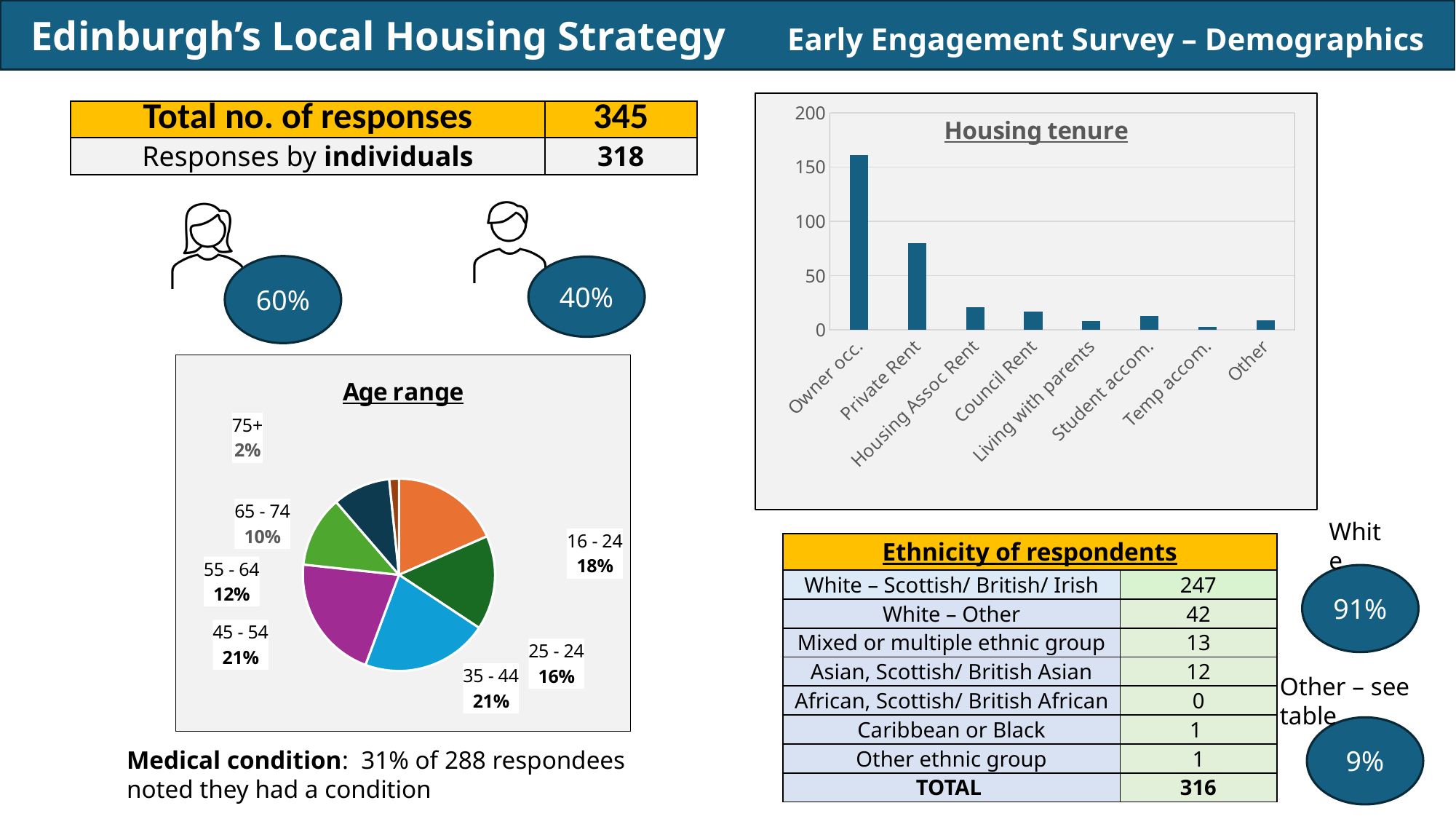
In the Housing tenure chart, which category has the highest value? Owner occ. In the Housing tenure chart, is the value for Owner occ. greater or less than 150? greater What kind of chart is the Age range chart? pie chart In the Housing tenure chart, which category has the lowest value? Temp accom. How many categories are shown in the Housing tenure chart? 8 In the Age range chart, what share of respondents are aged 65 - 74? 10% In the Housing tenure chart, is the value for Private Rent greater or less than 100? less In the Age range chart, what is the difference between the shares for 16 - 24 and 55 - 64? 6% In the Age range chart, which age group has the smallest share? 75+ In the Housing tenure chart, which is larger: Owner occ. or Private Rent? Owner occ. In the Age range chart, what share of respondents are aged 16 - 24? 18% What kind of chart is the Housing tenure chart? bar chart